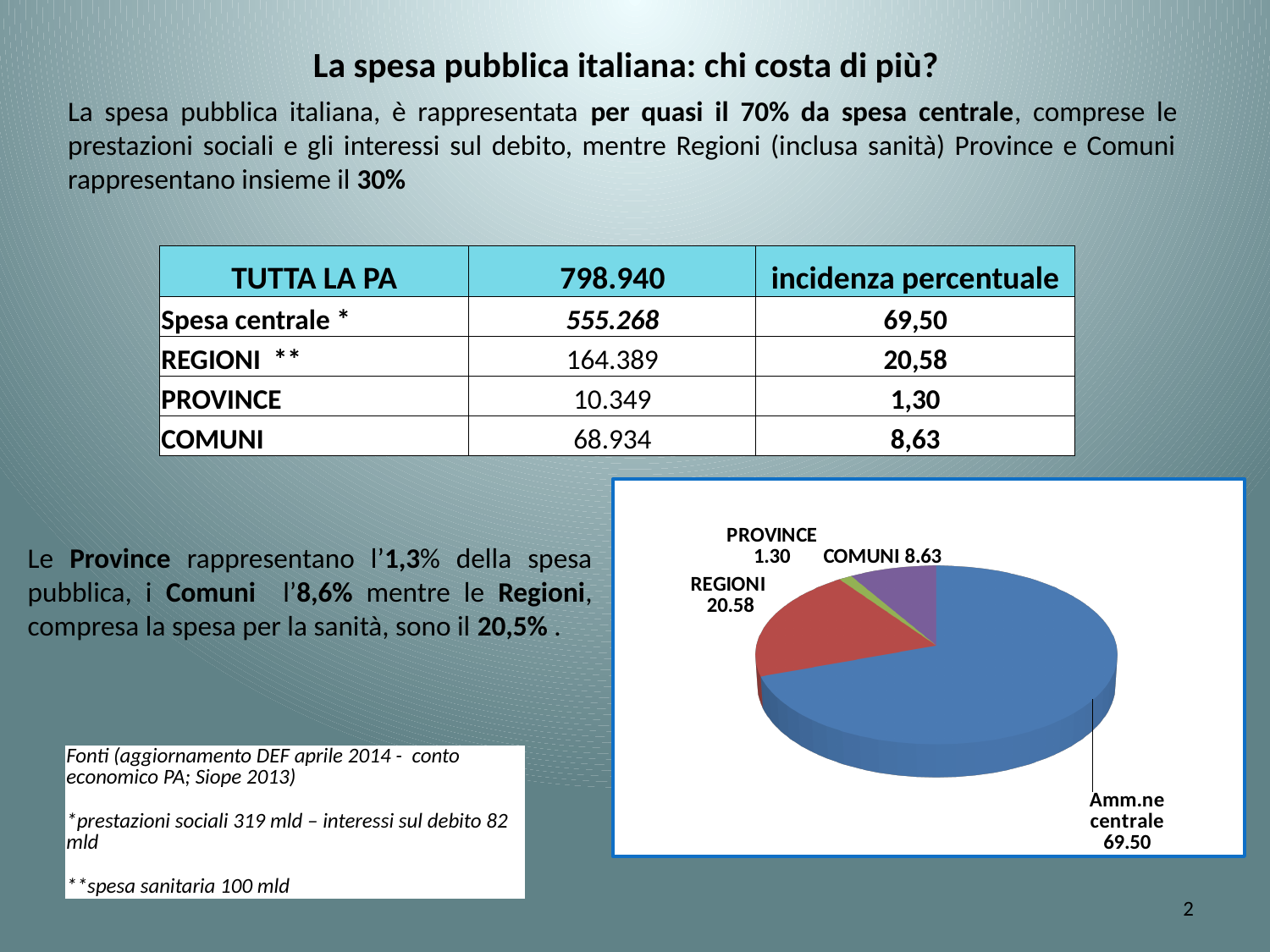
What value is shown for the REGIONI slice in the pie chart? 20.58 What kind of chart is shown on the slide? pie chart Which slice of the pie chart is the largest? Amm.ne centrale What value is shown for the Amm.ne centrale slice in the pie chart? 69.50 What colour is the Amm.ne centrale slice in the pie chart? blue What value is shown for the COMUNI slice in the pie chart? 8.63 What is the difference between the REGIONI and COMUNI values in the pie chart? 11.95 What is the difference between the Amm.ne centrale and REGIONI values in the pie chart? 48.92 What value is shown for the PROVINCE slice in the pie chart? 1.30 How many slices does the pie chart have? 4 Which slice of the pie chart is the smallest? PROVINCE In the pie chart, which is larger, REGIONI or COMUNI? REGIONI